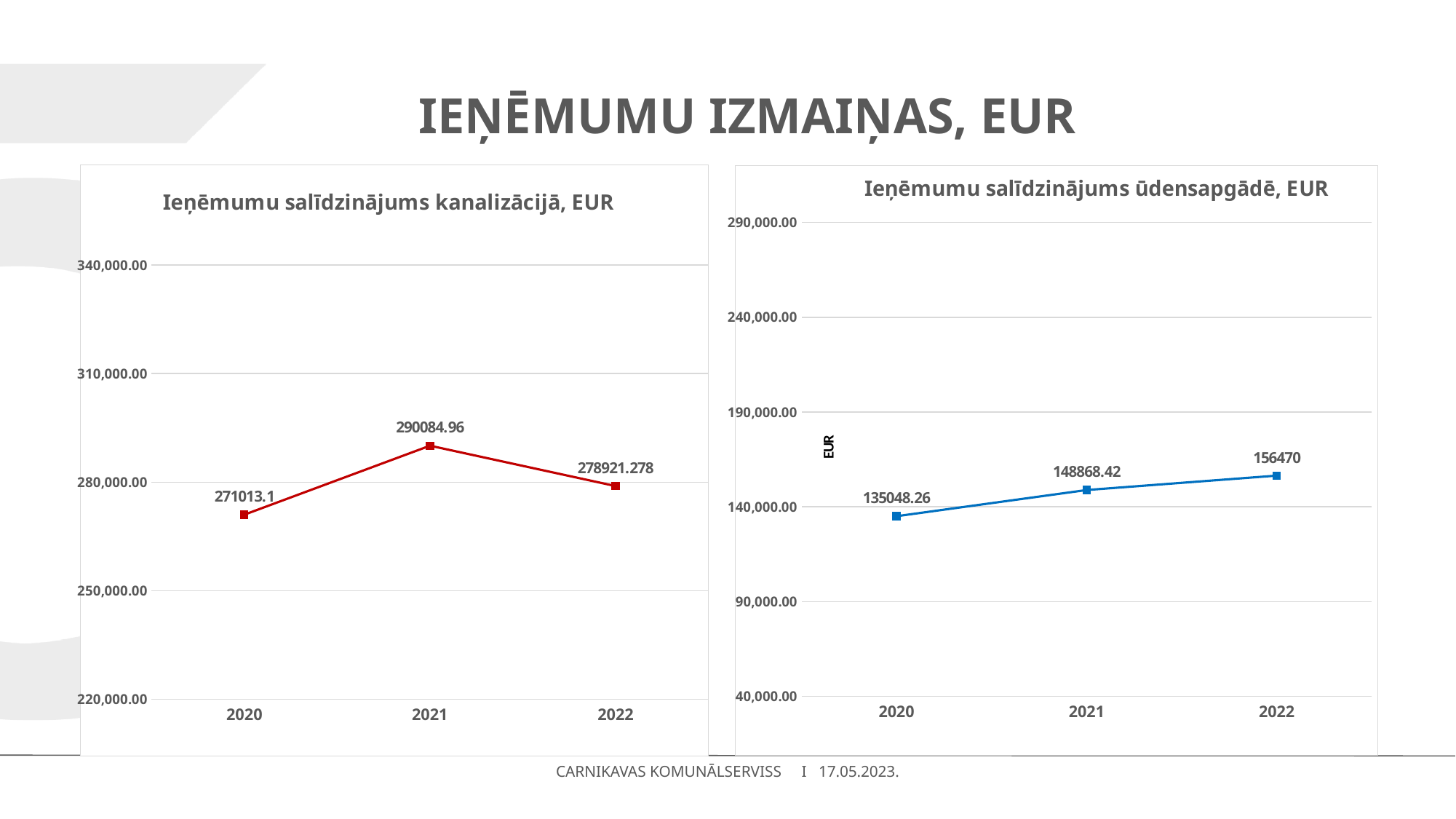
In the chart titled "Ieņēmumu salīdzinājums ūdensapgādē, EUR", what is the difference between the 2022 and 2020 values? 21421.74 In the chart titled "Ieņēmumu salīdzinājums ūdensapgādē, EUR", which year has the lowest value? 2020 In the chart titled "Ieņēmumu salīdzinājums ūdensapgādē, EUR", what is the value for 2022? 156470 In the chart titled "Ieņēmumu salīdzinājums kanalizācijā, EUR", which is larger, the value for 2022 or the value for 2020? 2022 In the chart titled "Ieņēmumu salīdzinājums kanalizācijā, EUR", what is the difference between the 2021 and 2020 values? 19071.86 In the chart titled "Ieņēmumu salīdzinājums kanalizācijā, EUR", what is the value for 2021? 290084.96 What kind of chart is the chart titled "Ieņēmumu salīdzinājums ūdensapgādē, EUR"? line chart In the chart titled "Ieņēmumu salīdzinājums kanalizācijā, EUR", which year has the highest value? 2021 In the chart titled "Ieņēmumu salīdzinājums kanalizācijā, EUR", what is the value for 2020? 271013.1 In the chart titled "Ieņēmumu salīdzinājums ūdensapgādē, EUR", do the values rise or fall from 2020 to 2022? rise In the chart titled "Ieņēmumu salīdzinājums ūdensapgādē, EUR", what is the value for 2020? 135048.26 How many years are plotted in the chart titled "Ieņēmumu salīdzinājums kanalizācijā, EUR"? 3